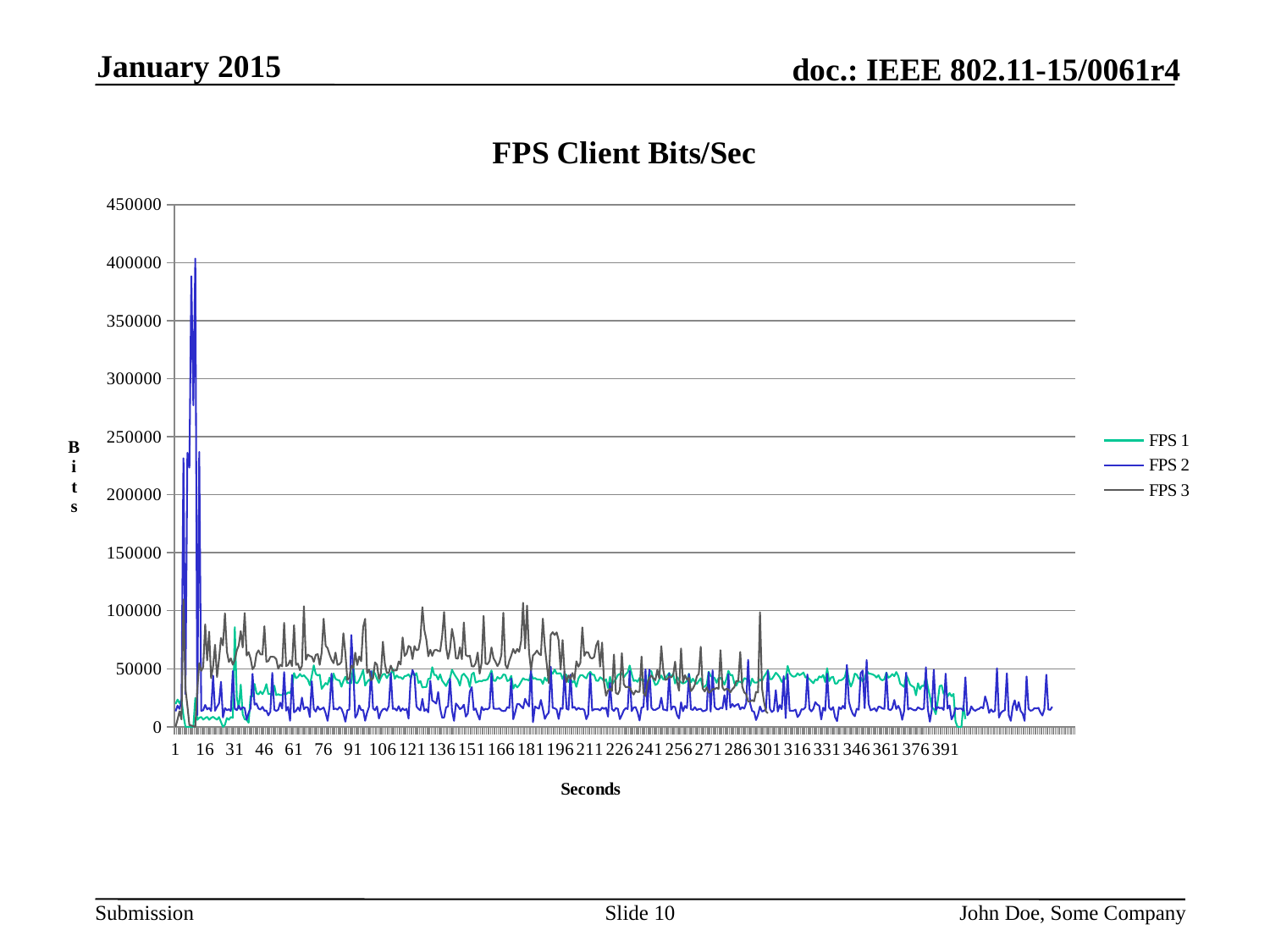
How many series does the legend list? 3 Is the highest value for FPS 1 greater or less than 100000? less What is the highest value shown on the y axis? 450000 Which series reaches the highest peak value on the chart? FPS 2 Which series has the higher peak, FPS 1 or FPS 3? FPS 3 Do the values for FPS 3 generally rise or fall as the seconds increase? fall What kind of chart is shown on the slide? line chart What is the title of the chart? FPS Client Bits/Sec What is the label on the x axis of the chart? Seconds Is the highest value for FPS 3 greater or less than 300000? less Is the highest value for FPS 2 greater or less than 350000? greater Which series has the lowest peak value on the chart? FPS 1